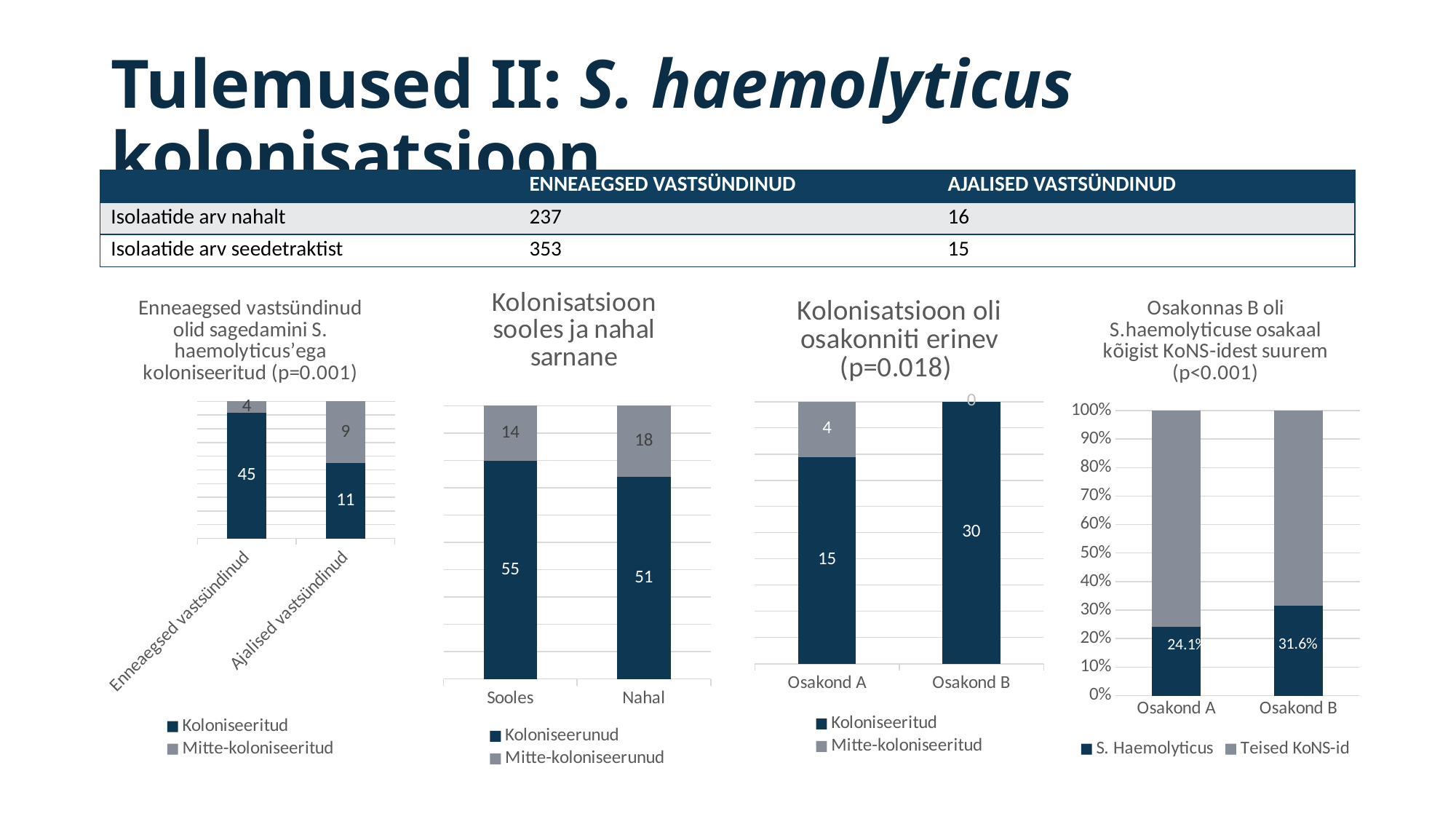
In the chart titled 'Kolonisatsioon oli osakonniti erinev (p=0.018)', what is the Koloniseeritud value for Osakond B? 30 In the chart titled 'Kolonisatsioon sooles ja nahal sarnane', what is the difference between the Mitte-koloniseerunud values for Nahal and Sooles? 4 In the rightmost chart (Osakonnas B oli S.haemolyticuse osakaal kõigist KoNS-idest suurem), is the S. Haemolyticus share for Osakond B greater or less than 30%? greater In the chart titled 'Kolonisatsioon oli osakonniti erinev (p=0.018)', how many series does the legend list? 2 What kind of chart is the chart titled 'Kolonisatsioon sooles ja nahal sarnane'? Stacked bar chart In the leftmost chart (Enneaegsed vastsündinud olid sagedamini S. haemolyticus'ega koloniseeritud), what is the Mitte-koloniseeritud value for Ajalised vastsündinud? 9 In the rightmost chart (Osakonnas B oli S.haemolyticuse osakaal kõigist KoNS-idest suurem), what is the S. Haemolyticus share for Osakond A? 24.1% In the chart titled 'Kolonisatsioon sooles ja nahal sarnane', which category has the higher Koloniseerunud value, Sooles or Nahal? Sooles In the chart titled 'Kolonisatsioon oli osakonniti erinev (p=0.018)', what is the total of the Osakond A bar? 19 In the chart titled 'Kolonisatsioon sooles ja nahal sarnane', what is the Koloniseerunud value for Nahal? 51 In the leftmost chart (Enneaegsed vastsündinud olid sagedamini S. haemolyticus'ega koloniseeritud), what is the total of the Enneaegsed vastsündinud bar? 49 In the leftmost chart (Enneaegsed vastsündinud olid sagedamini S. haemolyticus'ega koloniseeritud), what is the Koloniseeritud value for Enneaegsed vastsündinud? 45